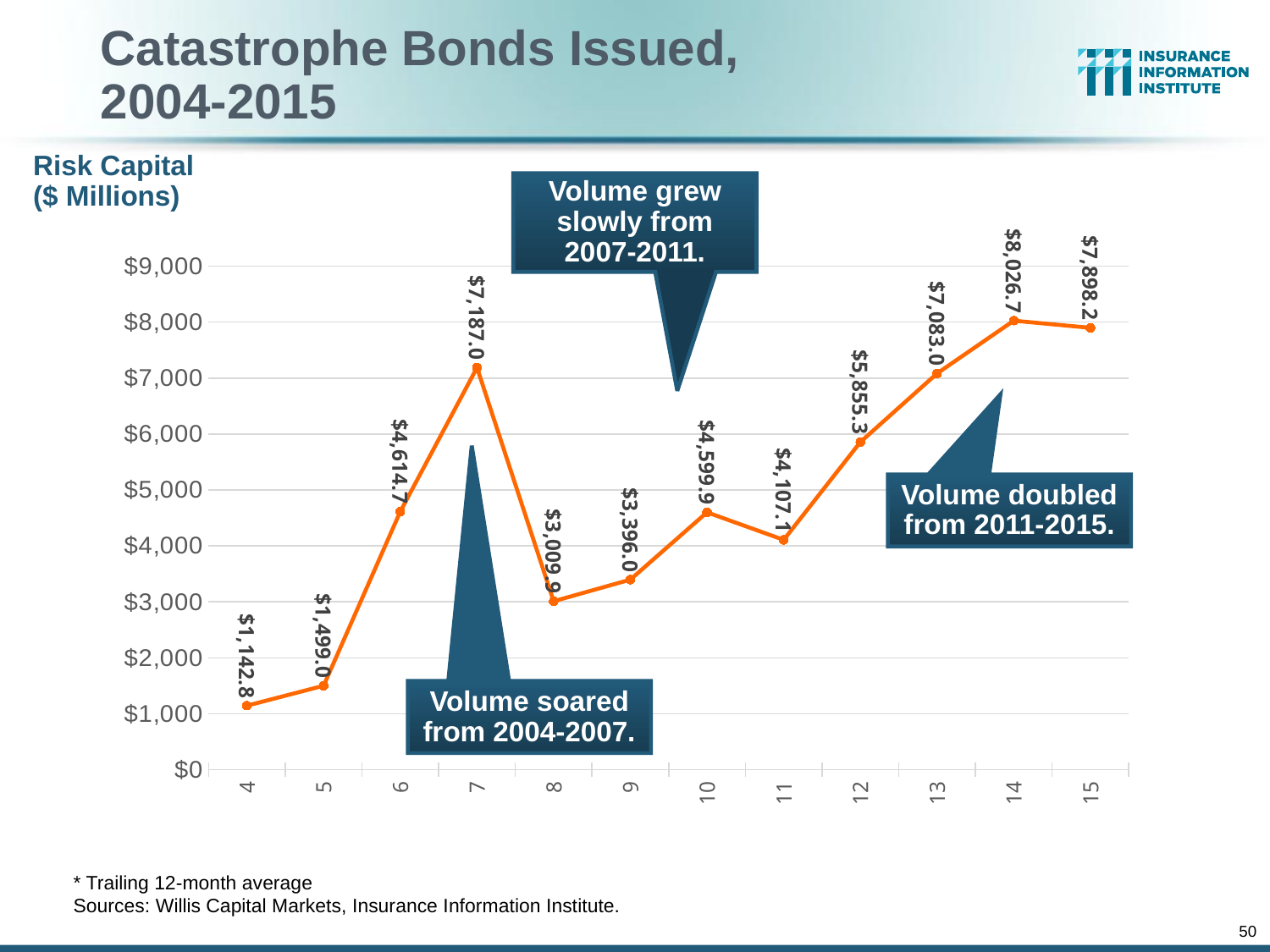
What does the label above the y-axis say the values are measured in? Risk Capital ($ Millions) What is the difference between the values at the points labeled 14 (2014) and 15 (2015)? $128.5 What is the risk capital value at the x-axis point labeled 7 (2007)? $7,187.0 What is the risk capital value at the x-axis point labeled 11 (2011)? $4,107.1 How many data points are plotted on the line? 12 Which is larger, the value at the point labeled 7 (2007) or the value at the point labeled 13 (2013)? 7 (2007) Which x-axis point has the lowest risk capital value? 4 (2004) Which x-axis point has the highest risk capital value? 14 (2014) What is the risk capital value at the x-axis point labeled 15 (2015)? $7,898.2 What kind of chart is shown on the slide? line chart Does the value rise or fall from the point labeled 7 (2007) to the point labeled 8 (2008)? fall What is the risk capital value at the x-axis point labeled 4 (2004)? $1,142.8